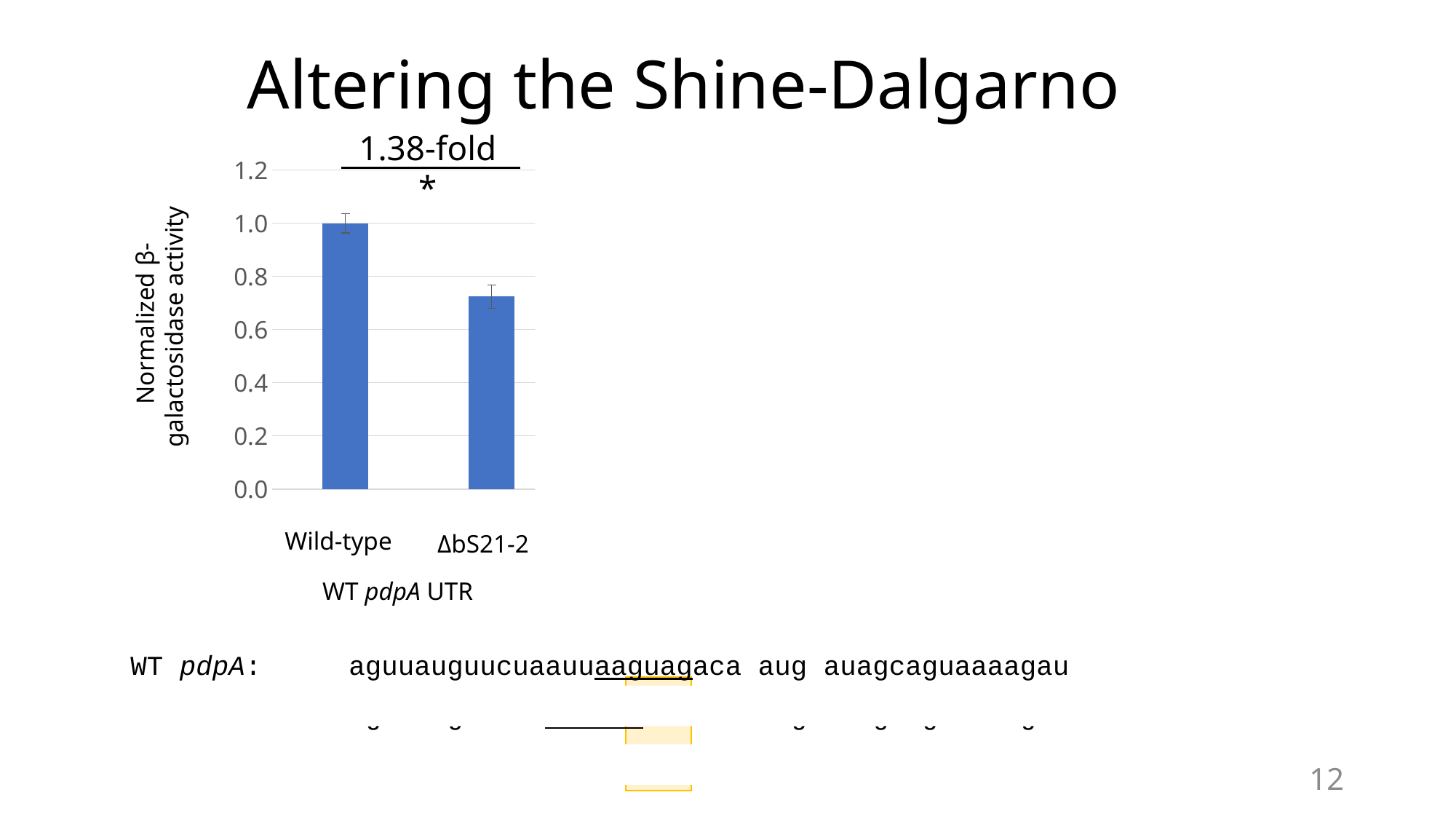
What fold change is annotated above the bars in the chart? 1.38-fold What type of chart is shown on the slide? bar chart Do the values rise or fall from Wild-type to ΔbS21-2? fall How many bars are plotted in the chart? 2 Is the value for ΔbS21-2 greater or less than 0.6? greater Which has a larger normalized β-galactosidase activity, Wild-type or ΔbS21-2? Wild-type Which category has the lowest normalized β-galactosidase activity? ΔbS21-2 What is the label of the y-axis of the chart? Normalized β-galactosidase activity Is the value for ΔbS21-2 greater or less than 0.8? less Which category has the highest normalized β-galactosidase activity? Wild-type What is the normalized β-galactosidase activity for Wild-type? 1.0